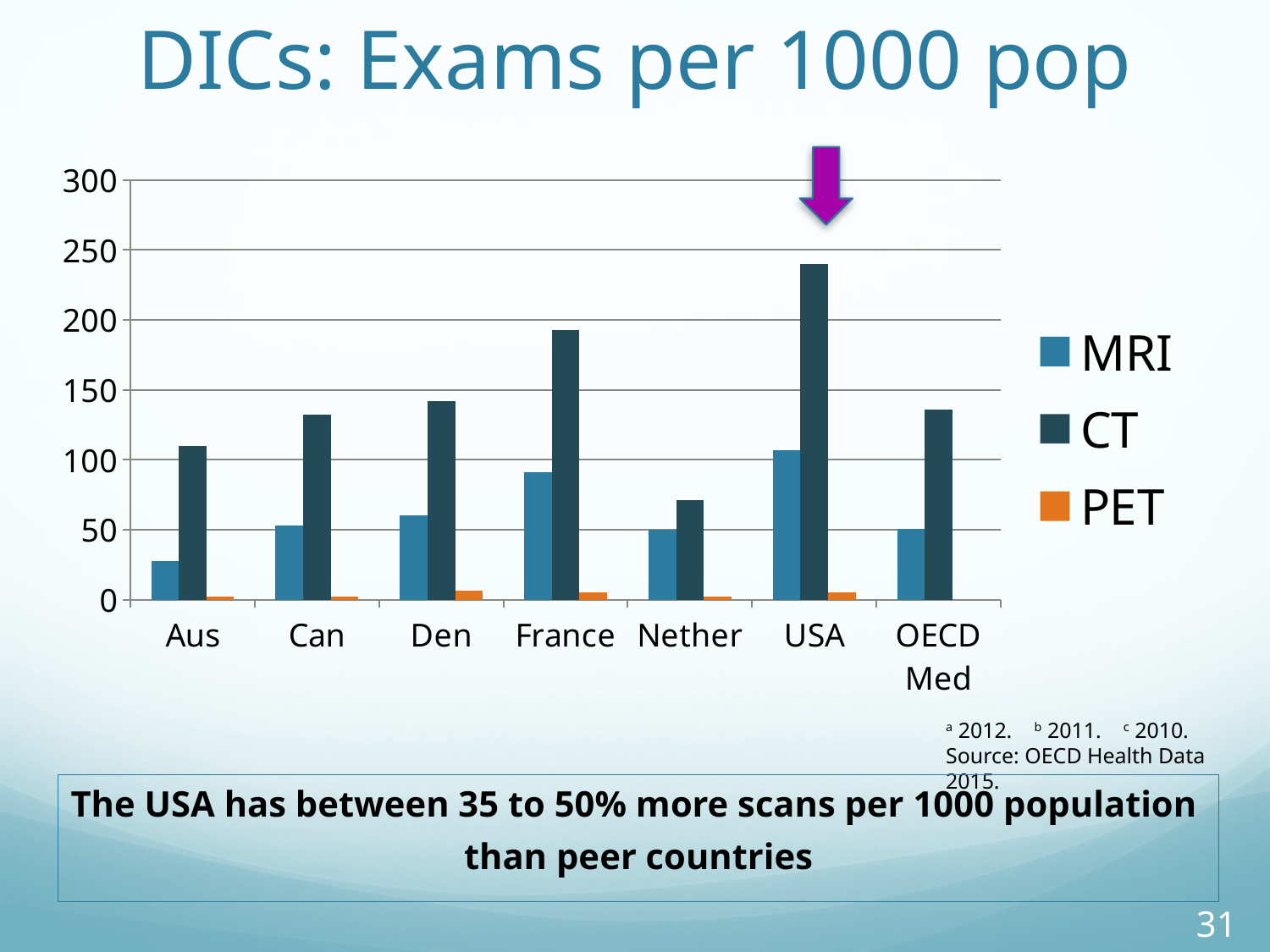
How many series does the legend list? 3 Is the CT value for USA greater or less than 200? greater What kind of chart is shown on the slide? Bar chart Is the CT value for Nether greater or less than 100? less What are the three series named in the legend? MRI, CT, PET Which category has the highest MRI value? USA Which category has the lowest CT value? Nether Is the MRI value for Aus greater or less than 50? less How many countries/categories are shown on the x axis? 7 Which category has the lowest MRI value? Aus Which has a larger CT value, France or Den? France Which category has the highest CT value? USA